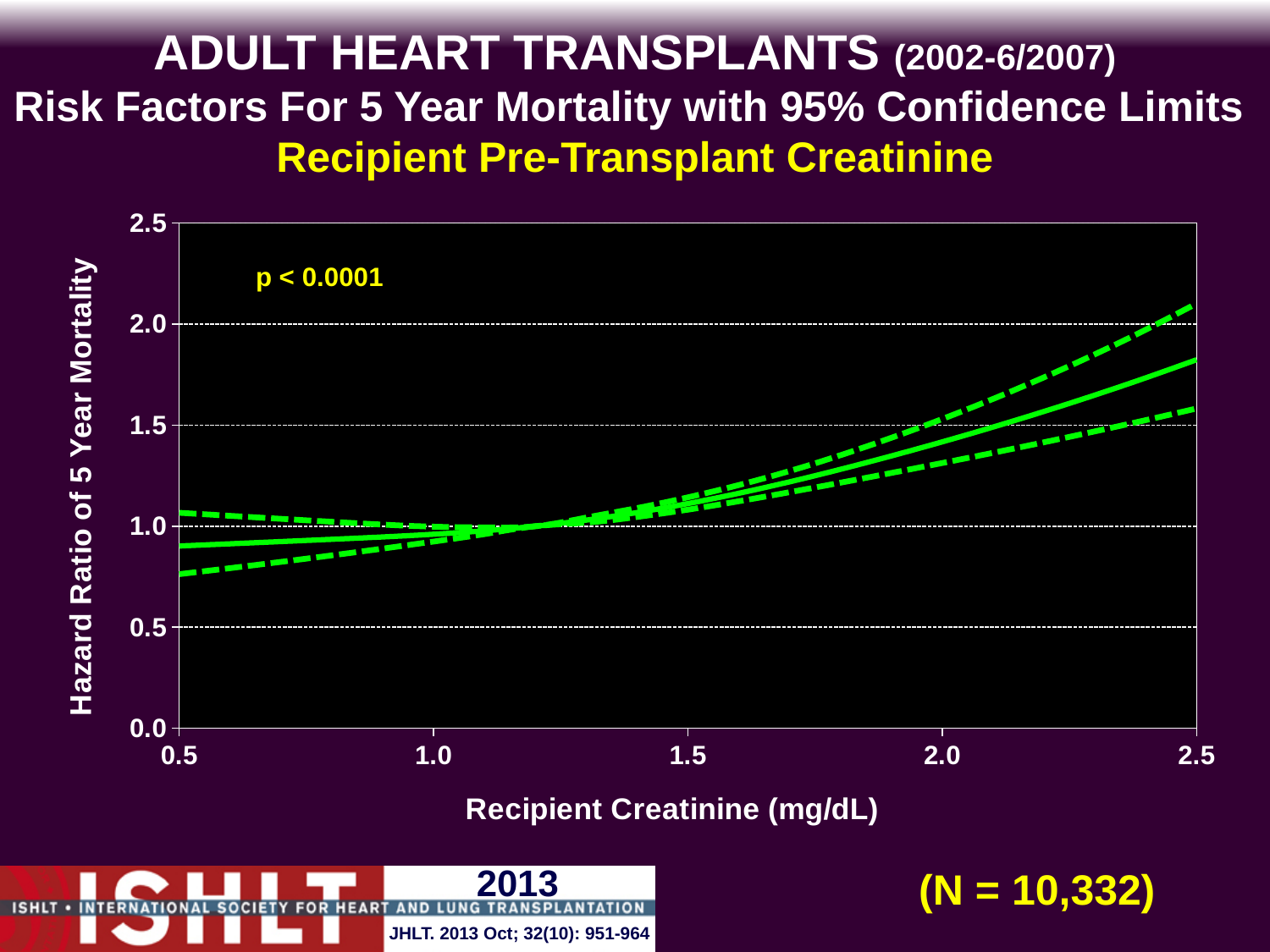
Is the hazard ratio (solid line) at a recipient creatinine of 2.5 mg/dL greater or less than 1.5? greater Which has the larger hazard ratio on the solid line: a recipient creatinine of 0.5 mg/dL or 2.5 mg/dL? 2.5 mg/dL What kind of chart is shown on the slide? line chart What is the label of the x axis? Recipient Creatinine (mg/dL) How many lines are plotted on the chart? 3 What is the label of the y axis? Hazard Ratio of 5 Year Mortality Does the hazard ratio of 5 year mortality rise or fall as recipient creatinine increases from 0.5 to 2.5 mg/dL? rise Is the hazard ratio (solid line) at a recipient creatinine of 1.5 mg/dL greater or less than 1.0? greater What p-value is printed on the chart? p < 0.0001 Is the hazard ratio (solid line) at a recipient creatinine of 0.5 mg/dL greater or less than 1.0? less